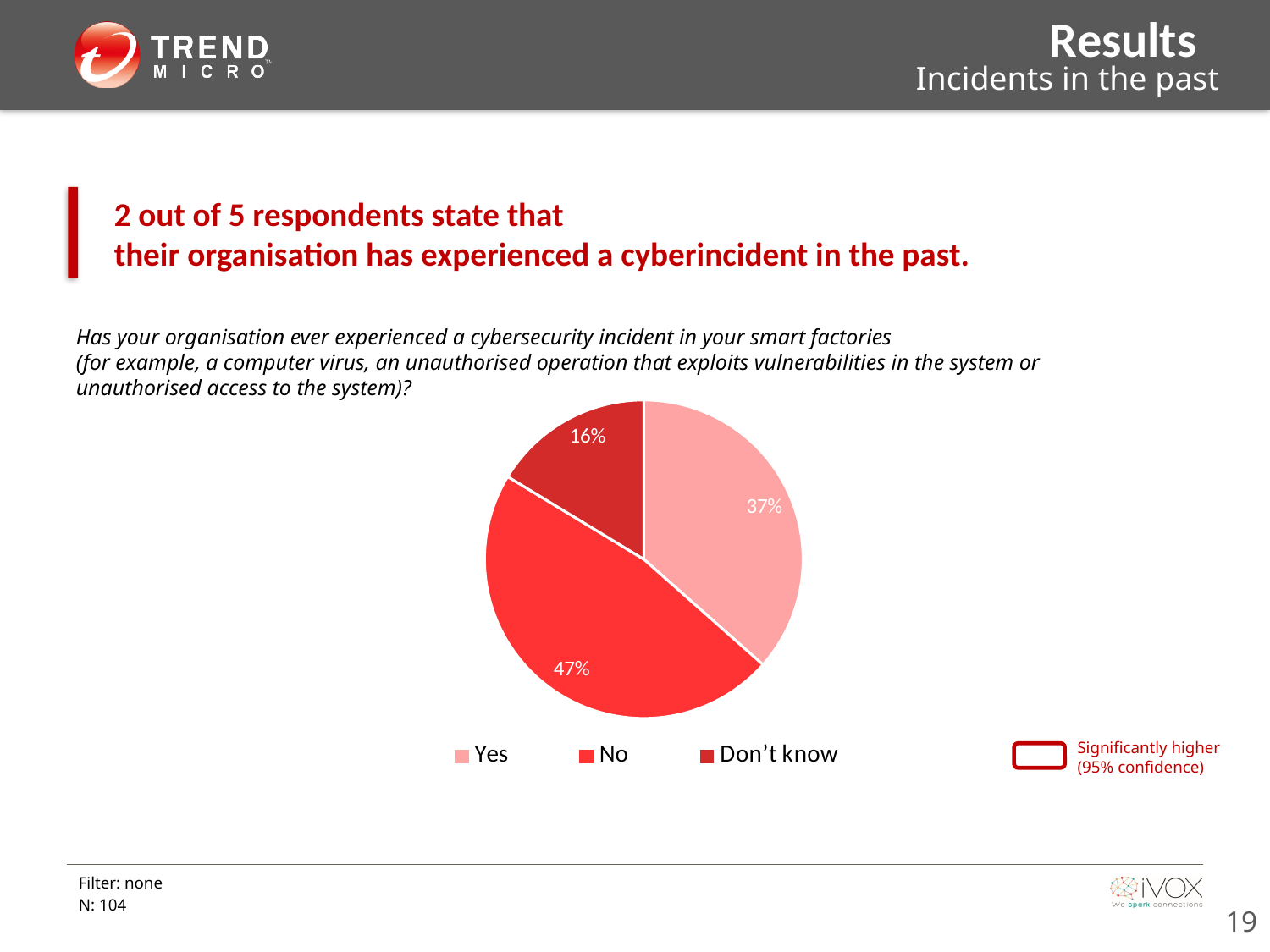
How many slices does the pie chart have? 3 What percentage of respondents answered "No"? 47% What percentage of respondents answered "Yes"? 37% What kind of chart is shown on the slide? pie chart Which response has the largest share of the pie? No How many entries does the legend list? 3 Which is larger, the share for "Yes" or the share for "Don't know"? Yes Which response has the smallest share of the pie? Don't know What is the difference in percentage points between the "No" and "Yes" slices? 10 Which legend entry is shown in the lightest shade of red/pink? Yes What percentage of respondents answered "Don't know"? 16% What is the difference in percentage points between the "Yes" and "Don't know" slices? 21